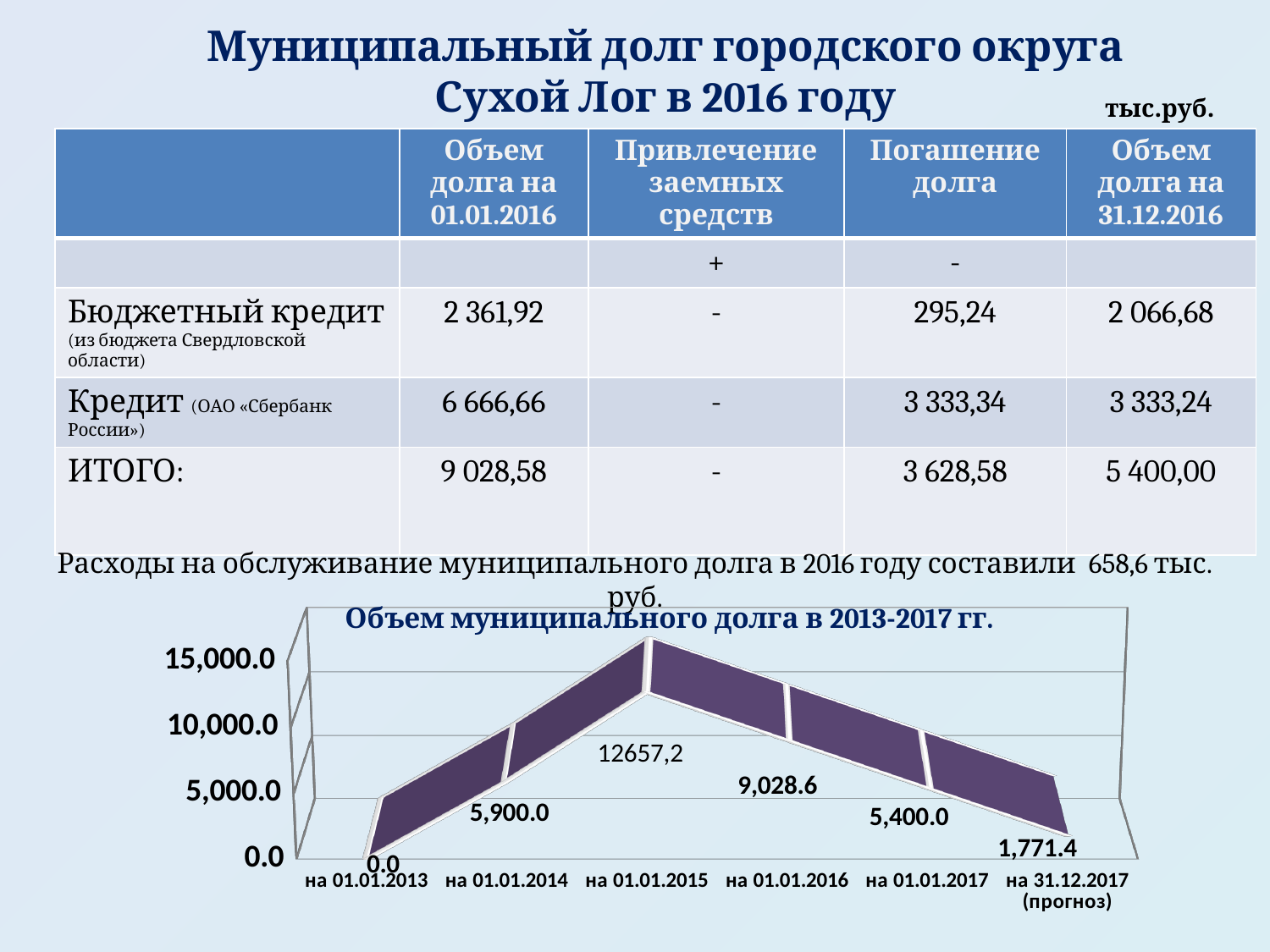
Which date has the highest value in the chart? на 01.01.2015 What is the difference between the values for на 01.01.2016 and на 01.01.2017? 3,628.6 What kind of chart is shown at the bottom of the slide? line chart What is the value for на 01.01.2014 in the chart? 5,900.0 Which date has the lowest value in the chart? на 01.01.2013 What is the value for на 01.01.2015 in the chart? 12657,2 What is the title of the chart on the slide? Объем муниципального долга в 2013-2017 гг. Which is larger, the value for на 01.01.2014 or the value for на 01.01.2017? на 01.01.2014 What is the value for на 01.01.2016 in the chart? 9,028.6 How many data points are plotted in the chart? 6 What is the value for на 31.12.2017 (прогноз) in the chart? 1,771.4 Is the value for на 01.01.2015 greater or less than 10,000.0? greater